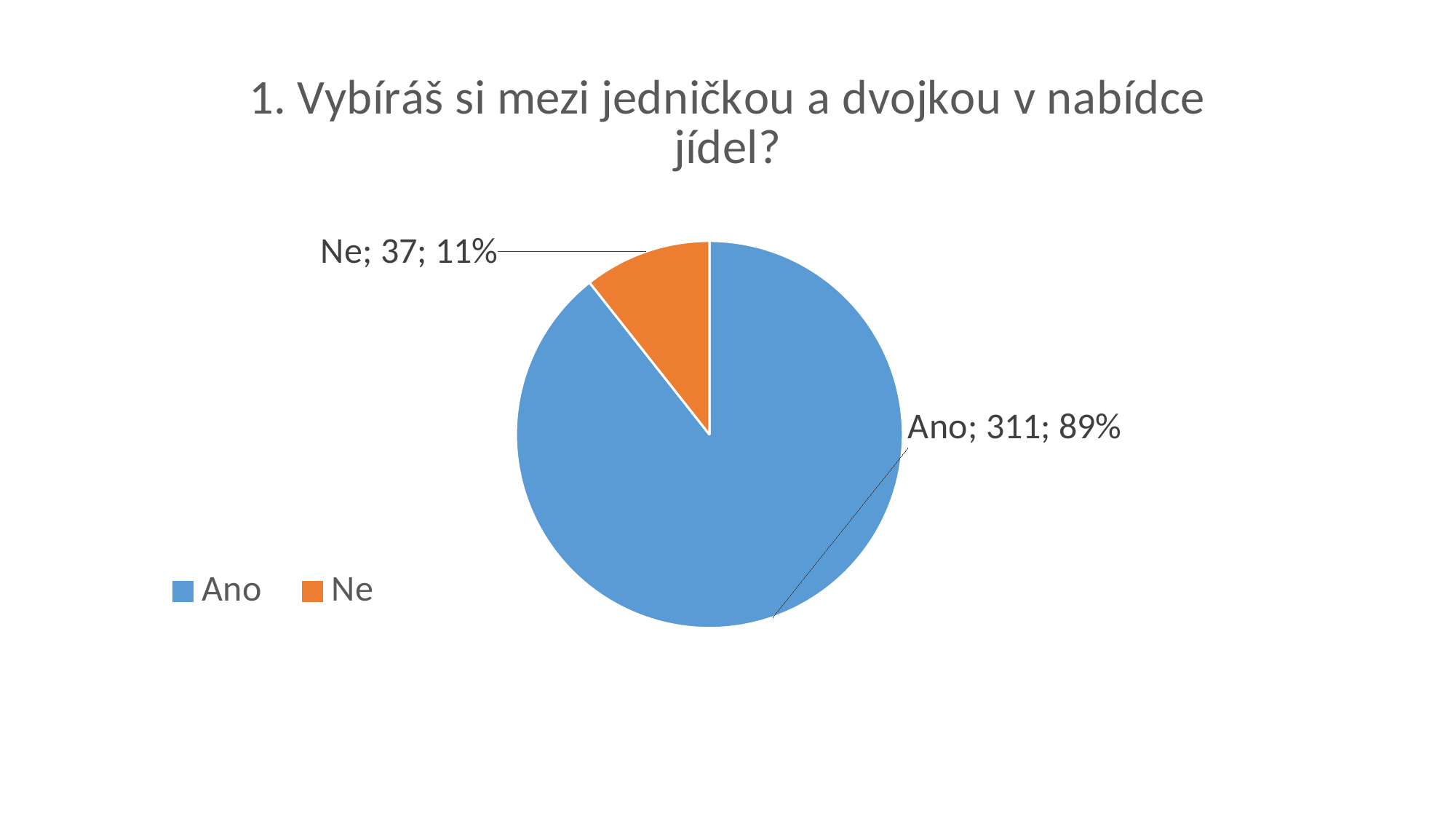
Which is larger, the value for Ano or the value for Ne? Ano What is the total of the values for Ano and Ne? 348 What is the value for Ne? 37 How many slices does the pie chart have? 2 What colour is the Ne slice? orange What is the difference between the values for Ano and Ne? 274 What share of the pie does the Ne slice represent? 11% What kind of chart is shown on the slide? pie chart Which category has the largest slice? Ano Which category has the smallest slice? Ne What is the value for Ano? 311 What share of the pie does the Ano slice represent? 89%